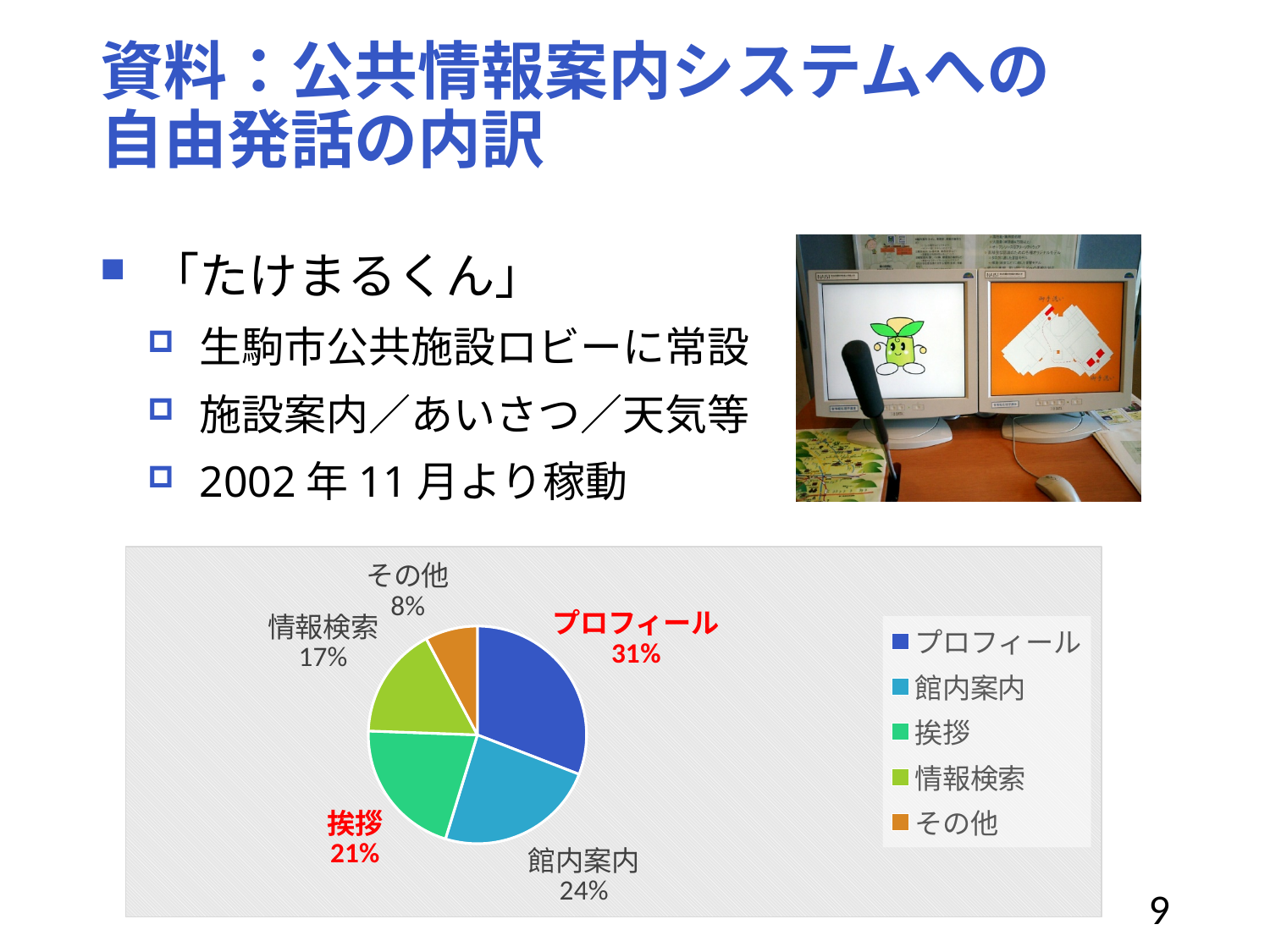
What is the difference in percentage points between プロフィール and 挨拶? 10 What share of the pie does 挨拶 have? 21% What kind of chart is shown on the slide? pie chart Which is larger, the share for 館内案内 or the share for 情報検索? 館内案内 What share of the pie does その他 have? 8% What share of the pie does 館内案内 have? 24% Which category has the largest slice of the pie? プロフィール What share of the pie does プロフィール have? 31% How many categories does the pie chart have? 5 Which category has the smallest slice of the pie? その他 What share of the pie does 情報検索 have? 17% What colour is the プロフィール slice in the pie chart? blue